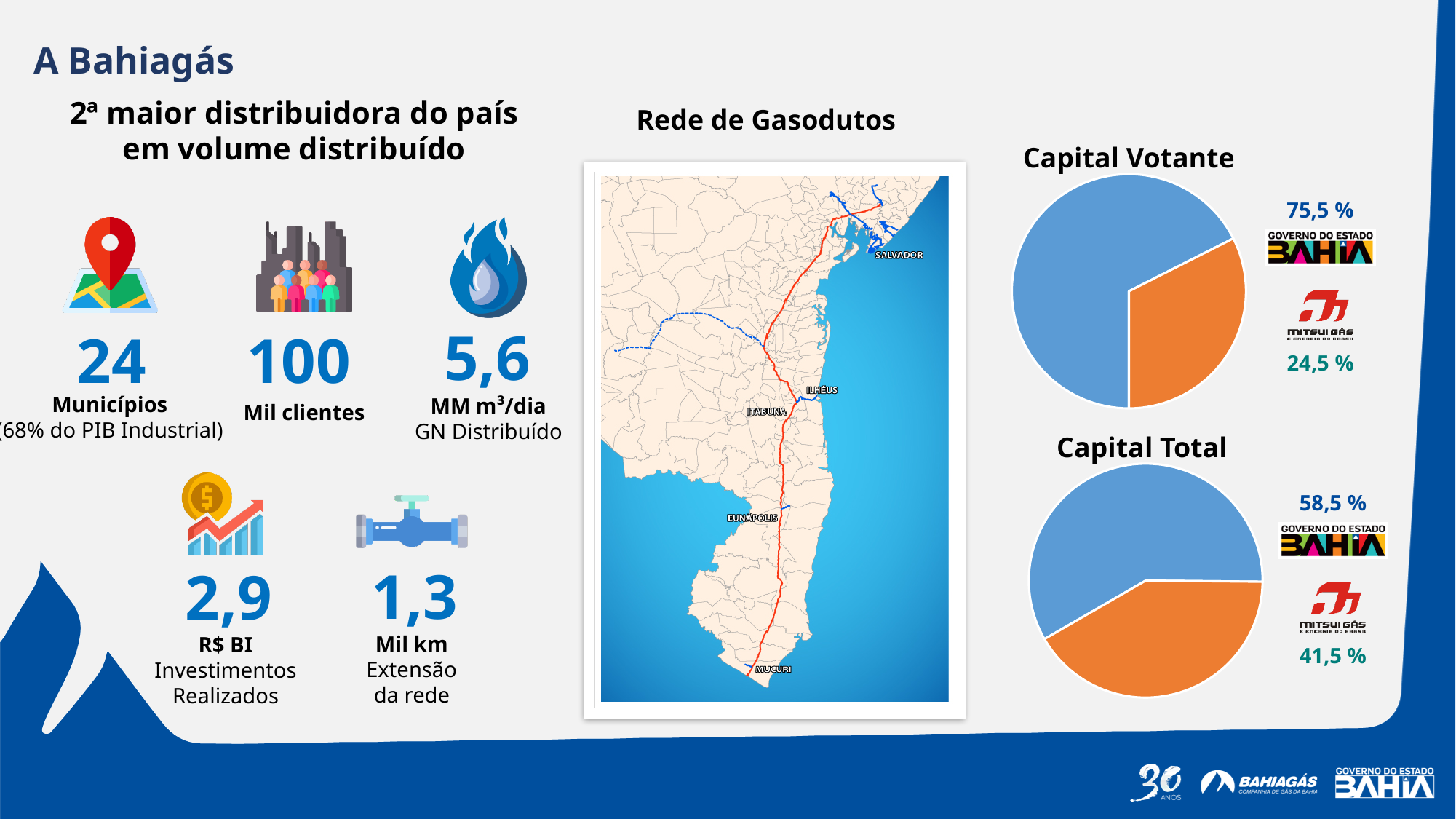
What kind of chart is the Capital Total chart? Pie chart In the Capital Total chart, what colour is the Mitsui Gás slice? Orange In the Capital Total chart, which shareholder has the smallest slice? Mitsui Gás In the Capital Total chart, what share does Governo do Estado Bahia hold? 58,5 % In the Capital Votante chart, what is the difference between the Governo do Estado Bahia share and the Mitsui Gás share? 51 % In the Capital Votante chart, what share does Mitsui Gás hold? 24,5 % Is the Mitsui Gás share larger in the Capital Votante chart or in the Capital Total chart? Capital Total In the Capital Votante chart, what share does Governo do Estado Bahia hold? 75,5 % In the Capital Total chart, what share does Mitsui Gás hold? 41,5 % In the Capital Total chart, what is the difference between the Governo do Estado Bahia share and the Mitsui Gás share? 17 % In the Capital Votante chart, which shareholder has the largest slice? Governo do Estado Bahia How many slices does the Capital Votante pie chart have? 2